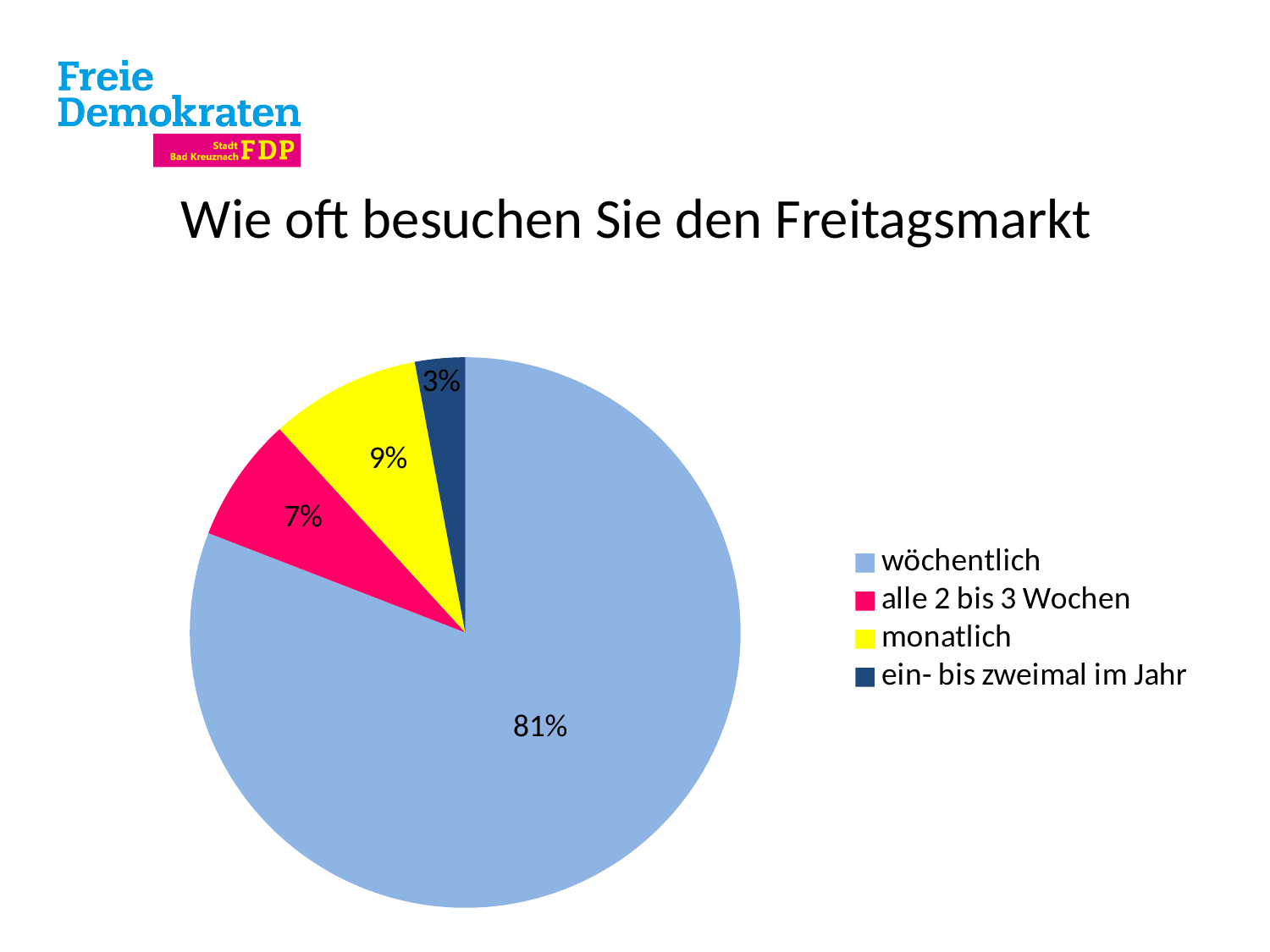
What kind of chart is shown on the slide? pie chart Which category has the smallest slice of the pie? ein- bis zweimal im Jahr What share of the pie does "wöchentlich" represent? 81% What is the title of the chart? Wie oft besuchen Sie den Freitagsmarkt What is the difference between the values for "wöchentlich" and "monatlich"? 72% What is the difference between the values for "monatlich" and "alle 2 bis 3 Wochen"? 2% How many categories does the pie chart show? 4 What is the value for "alle 2 bis 3 Wochen"? 7% What is the value for "monatlich"? 9% Which category has the largest slice of the pie? wöchentlich What is the value for "ein- bis zweimal im Jahr"? 3% Which is larger, the value for "monatlich" or the value for "alle 2 bis 3 Wochen"? monatlich